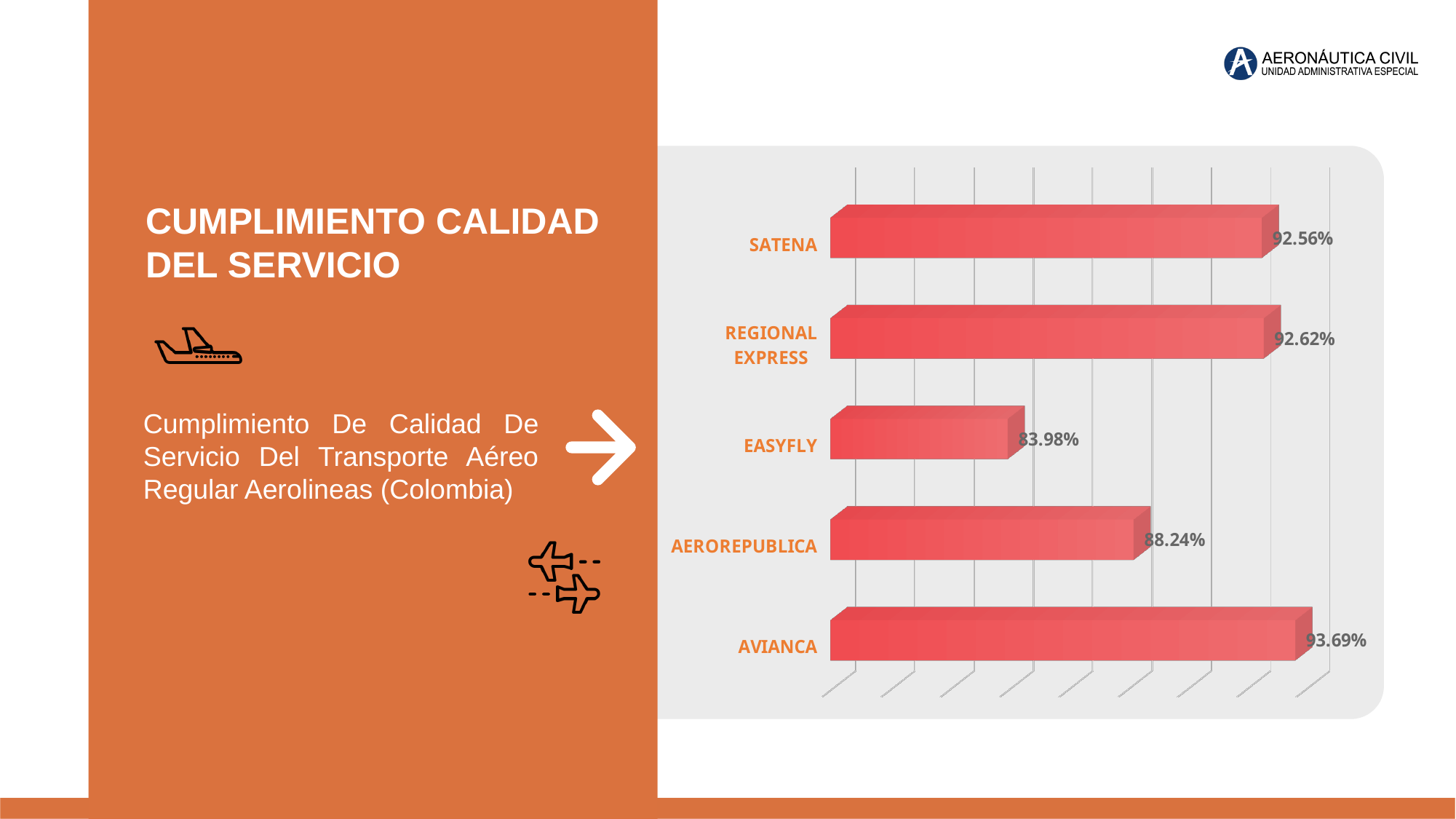
Which airline has the highest value? AVIANCA Which is larger, the value for AEROREPUBLICA or the value for EASYFLY? AEROREPUBLICA What is the value for SATENA? 92.56% How many airlines are shown in the chart? 5 What is the value for AVIANCA? 93.69% What is the difference between the values for AEROREPUBLICA and EASYFLY? 4.26% What is the value for AEROREPUBLICA? 88.24% What is the value for EASYFLY? 83.98% Which airline has the lowest value? EASYFLY What is the value for REGIONAL EXPRESS? 92.62% What kind of chart is shown on the slide? Bar chart What is the difference between the values for AVIANCA and EASYFLY? 9.71%